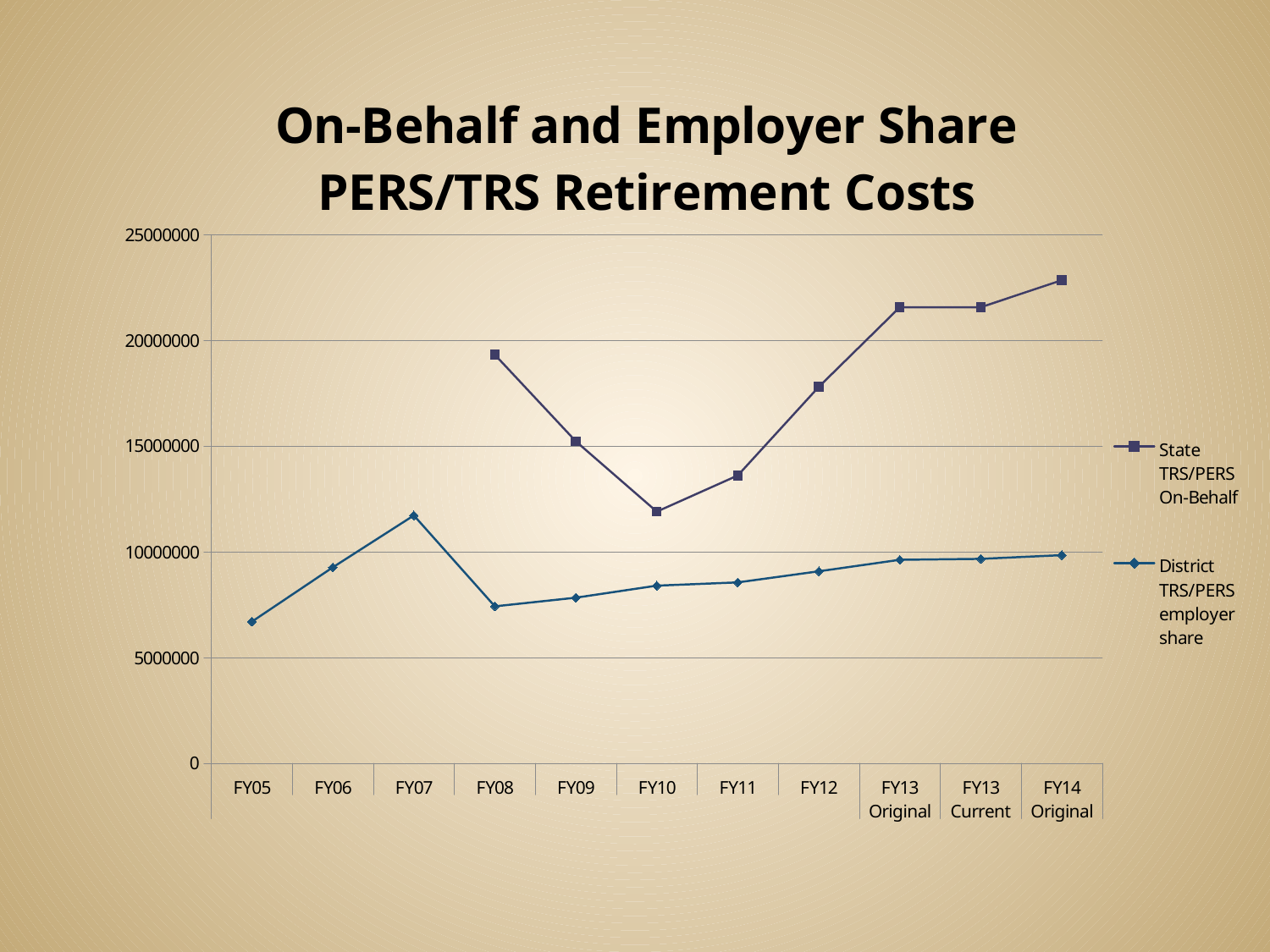
Is the State TRS/PERS On-Behalf value for FY13 Original greater or less than 20000000? greater Is the District TRS/PERS employer share value for FY07 greater or less than 10000000? greater Is the State TRS/PERS On-Behalf value for FY10 greater or less than 15000000? less How many categories are shown on the x axis? 11 How many series does the legend list? 2 Which category has the highest value for the State TRS/PERS On-Behalf series? FY14 Original Which category has the lowest value for the District TRS/PERS employer share series? FY05 Which category has the lowest value for the State TRS/PERS On-Behalf series? FY10 Which category has the highest value for the District TRS/PERS employer share series? FY07 What kind of chart is shown on the slide? line chart Does the State TRS/PERS On-Behalf series rise or fall from FY10 to FY14 Original? rise Which is larger in FY12: the State TRS/PERS On-Behalf value or the District TRS/PERS employer share value? State TRS/PERS On-Behalf